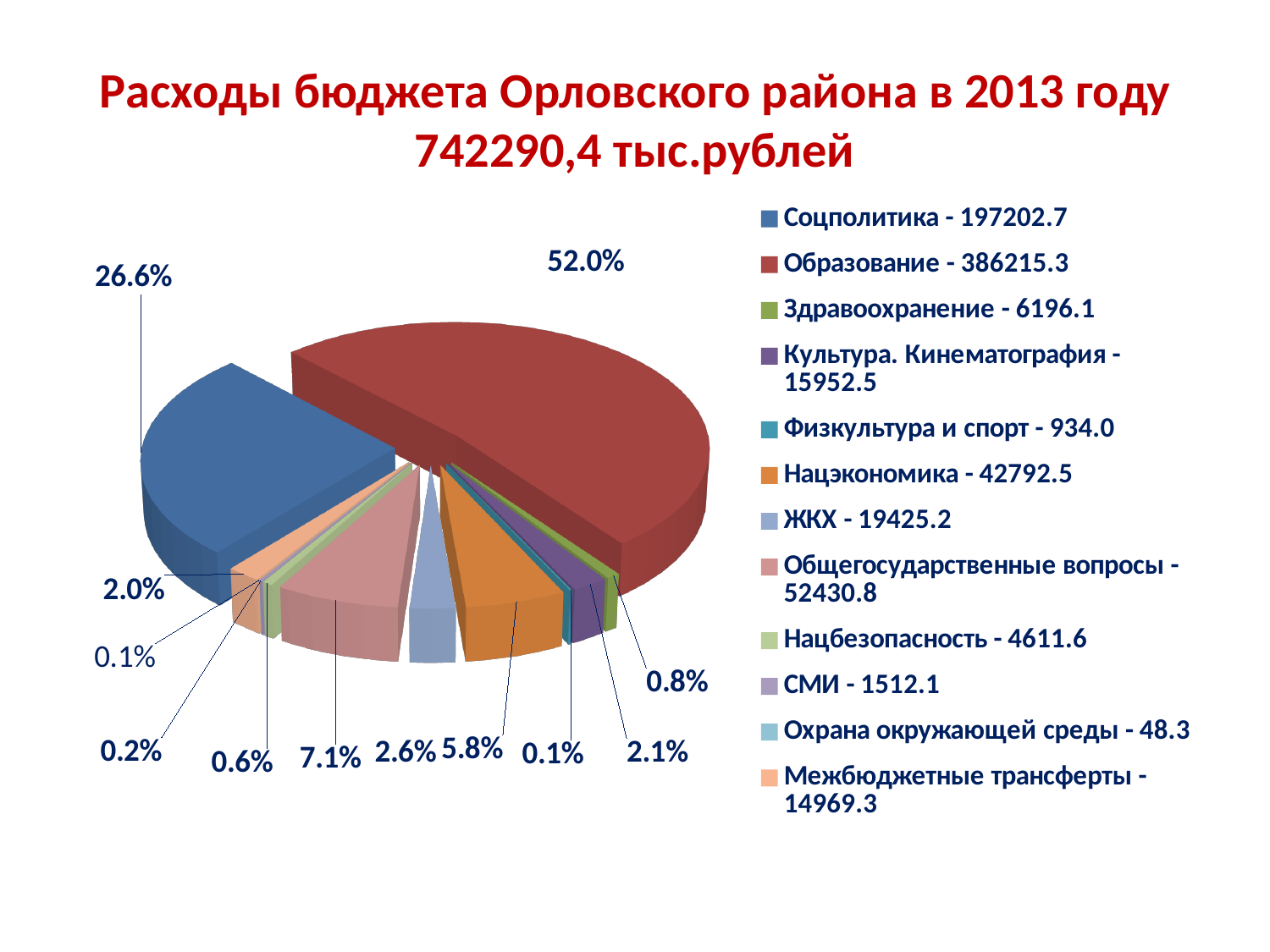
Which category has the smallest value in the legend? Охрана окружающей среды What value is given for Нацэкономика in the legend? 42792.5 What is the total budget expenditure stated in the chart title? 742290,4 тыс.рублей What value is given for Соцполитика in the legend? 197202.7 How many categories does the legend of the pie chart list? 12 What share of the pie does Соцполитика take? 26.6% Which category has the largest share of the pie? Образование Which is larger, the value for Нацэкономика or the value for ЖКХ? Нацэкономика What value is given for Образование in the legend? 386215.3 What share of the pie does Образование take? 52.0% What kind of chart is shown on the slide? pie chart What is the difference between the values for Образование and Соцполитика? 189012.6